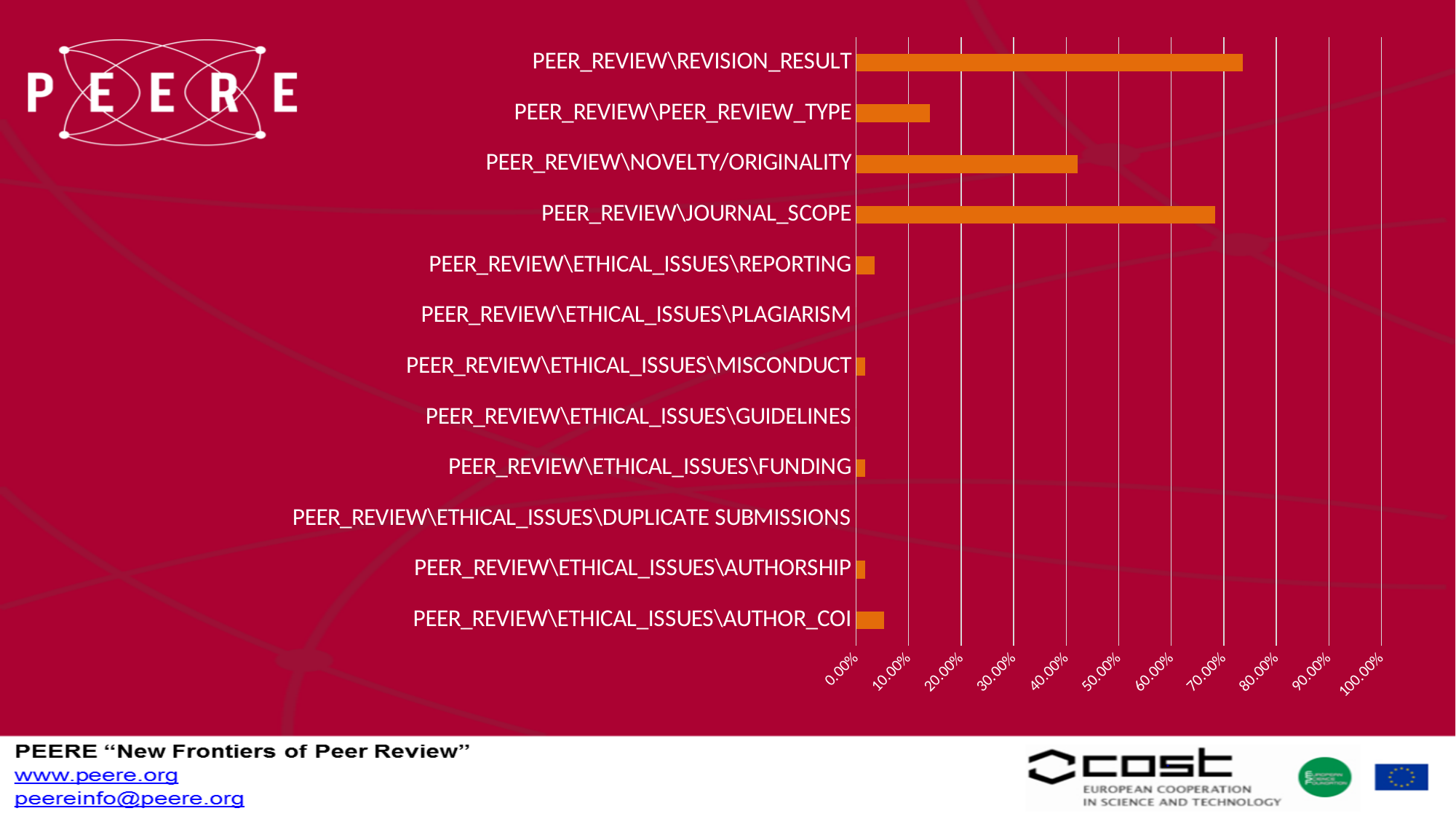
Is the value for PEER_REVIEW\REVISION_RESULT greater or less than 70.00%? greater How many categories are listed on the chart's vertical axis? 12 Which is larger, the value for PEER_REVIEW\JOURNAL_SCOPE or the value for PEER_REVIEW\NOVELTY/ORIGINALITY? PEER_REVIEW\JOURNAL_SCOPE Is the value for PEER_REVIEW\ETHICAL_ISSUES\AUTHOR_COI greater or less than 10.00%? less Is the value for PEER_REVIEW\PEER_REVIEW_TYPE greater or less than 20.00%? less Which is larger, the value for PEER_REVIEW\PEER_REVIEW_TYPE or the value for PEER_REVIEW\ETHICAL_ISSUES\REPORTING? PEER_REVIEW\PEER_REVIEW_TYPE What kind of chart is shown on the slide? Bar chart What is the highest value shown on the chart's horizontal axis? 100.00% How many categories on the chart show no visible bar at all? 3 Which category has the longest bar? PEER_REVIEW\REVISION_RESULT